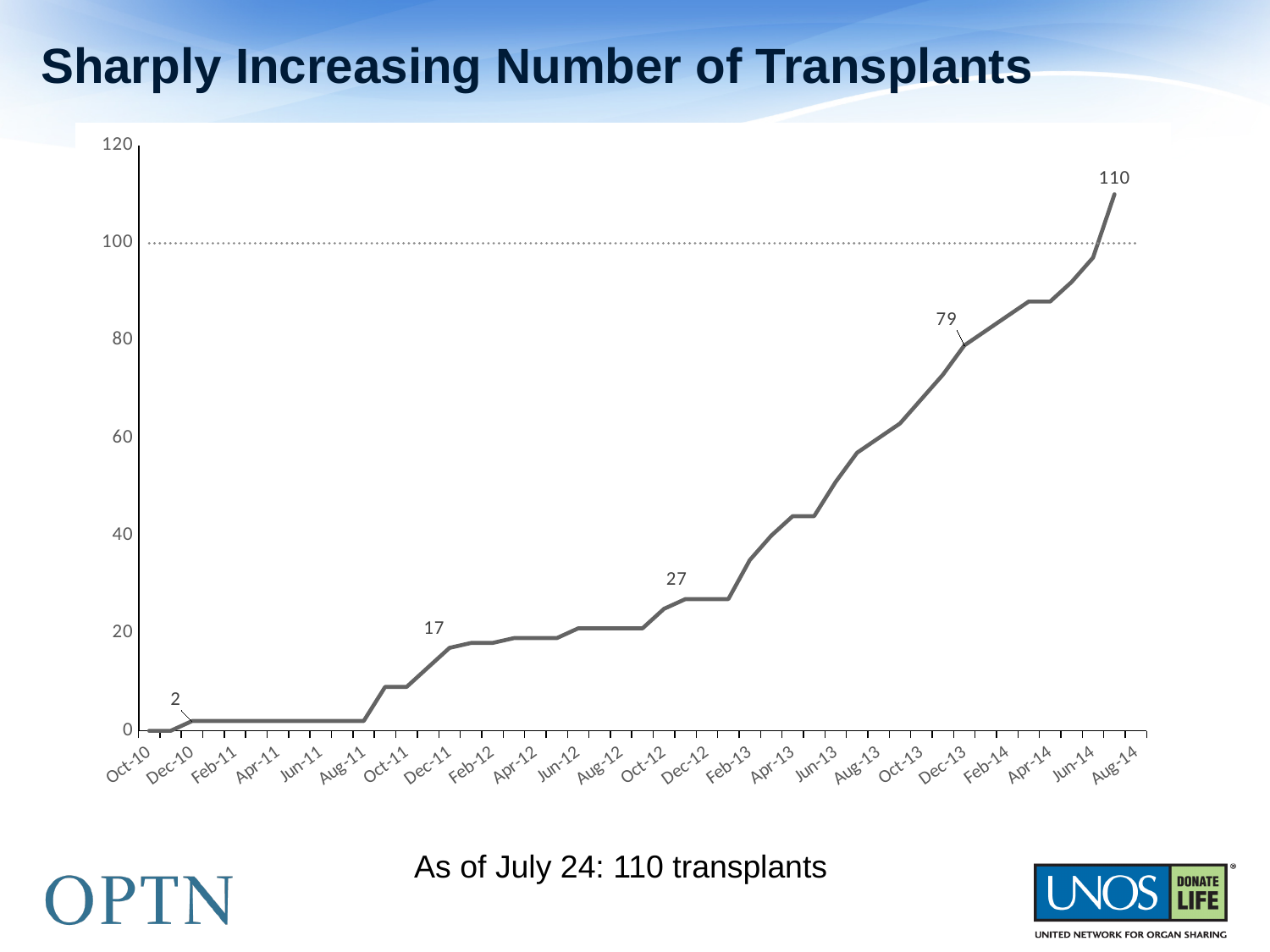
What is the title of the chart? Sharply Increasing Number of Transplants What value is labeled on the line at Dec-11? 17 What value is labeled on the line at Dec-10? 2 What kind of chart is shown on the slide? line chart What is the difference between the final labeled value (110) and the labeled value at Dec-13? 31 What value is labeled on the line at Dec-12? 27 Is the value at Jun-13 greater or less than 40? greater What is the value shown by the data label at the end of the line (the last point)? 110 Do the values generally rise or fall from Oct-10 to Aug-14? rise What is the difference between the labeled values at Dec-13 and Dec-12? 52 How many data labels are printed on the line? 5 What value is labeled on the line at Dec-13? 79